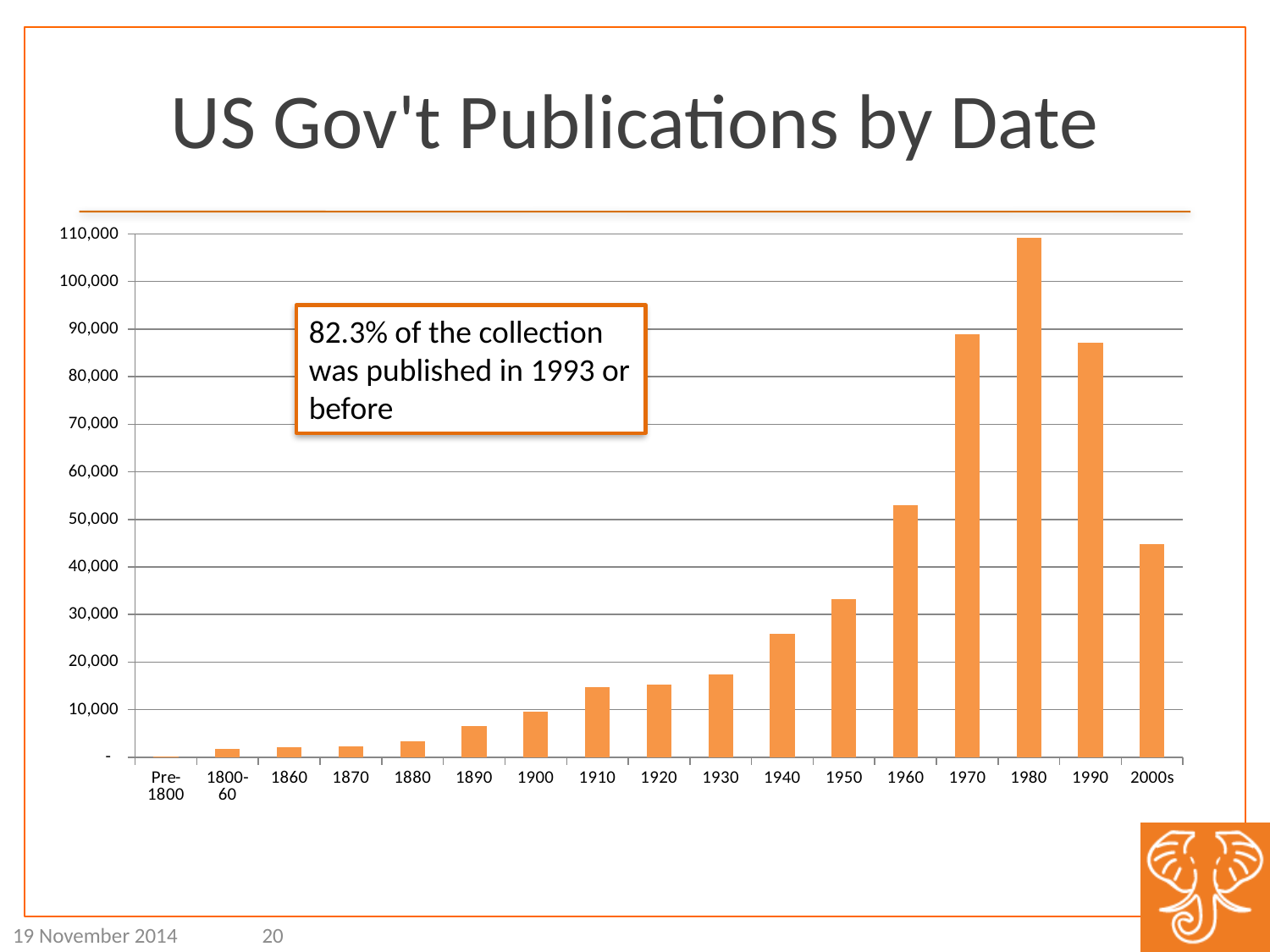
Do the values rise or fall from 1860 through 1980? rise Is the value for 2000s greater or less than 50,000? less Is the value for 1930 greater or less than 20,000? less Which has more publications, 1960 or 2000s? 1960 Which date category has the highest number of publications? 1980 Is the value for 1990 greater or less than 80,000? greater How many date categories are shown on the x axis? 17 What is the title of the chart? US Gov't Publications by Date Which date category has the lowest number of publications? Pre-1800 What kind of chart is shown on the slide? bar chart